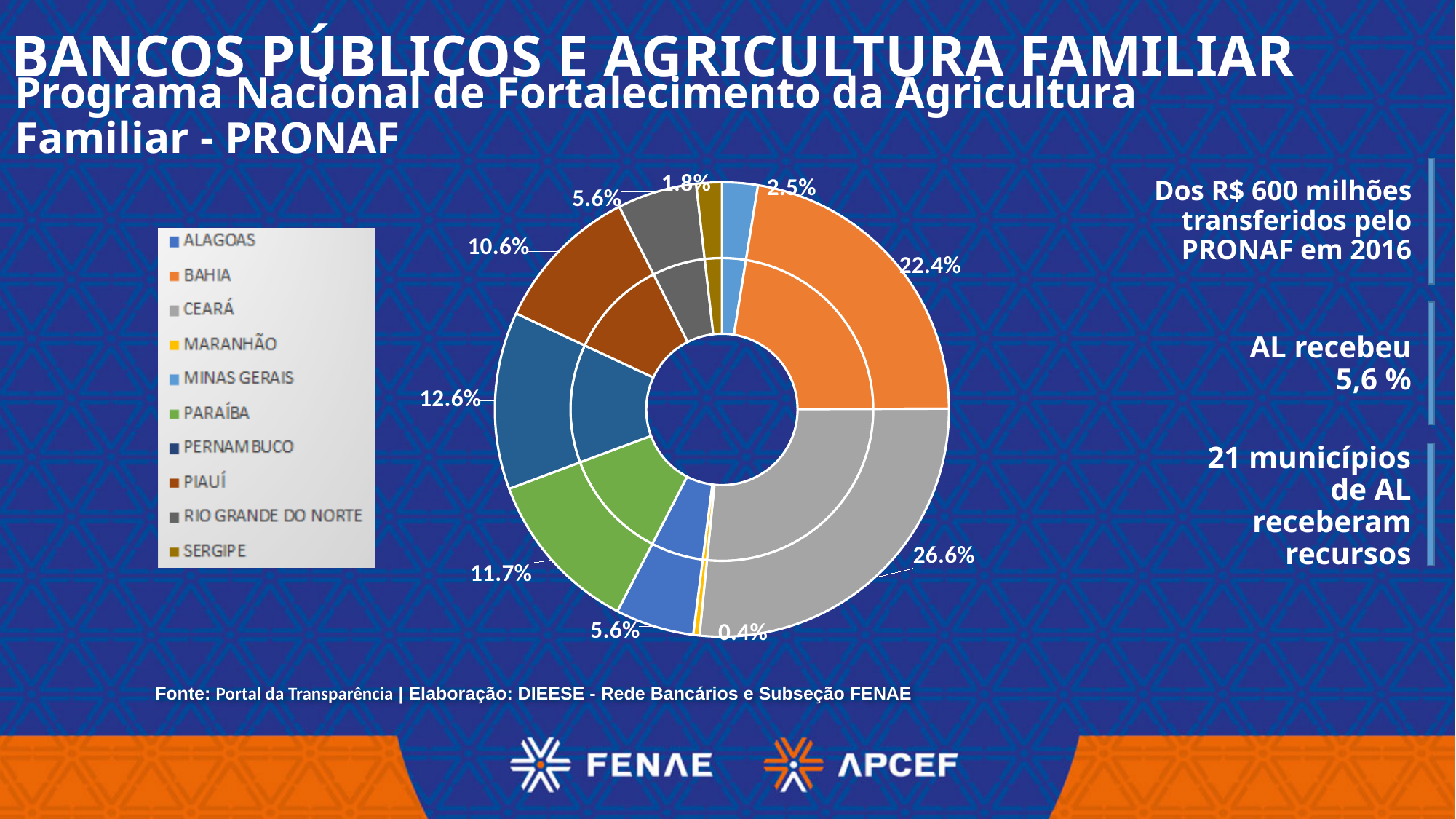
What share of the PRONAF transfers does the outer ring show for Ceará? 26.6% What share does the outer ring show for Piauí? 10.6% What share does the outer ring show for Bahia? 22.4% In the outer ring, which has the larger share, Pernambuco or Paraíba? Pernambuco What share does the outer ring show for Pernambuco? 12.6% What share does the outer ring show for Paraíba? 11.7% What share does the outer ring show for Maranhão? 0.4% What kind of chart is shown on the slide? Doughnut chart Which state has the smallest share in the outer ring of the chart? Maranhão Which state has the largest share in the outer ring of the chart? Ceará How many states does the chart legend list? 10 In the outer ring, what is the difference between the shares of Ceará and Bahia? 4.2%